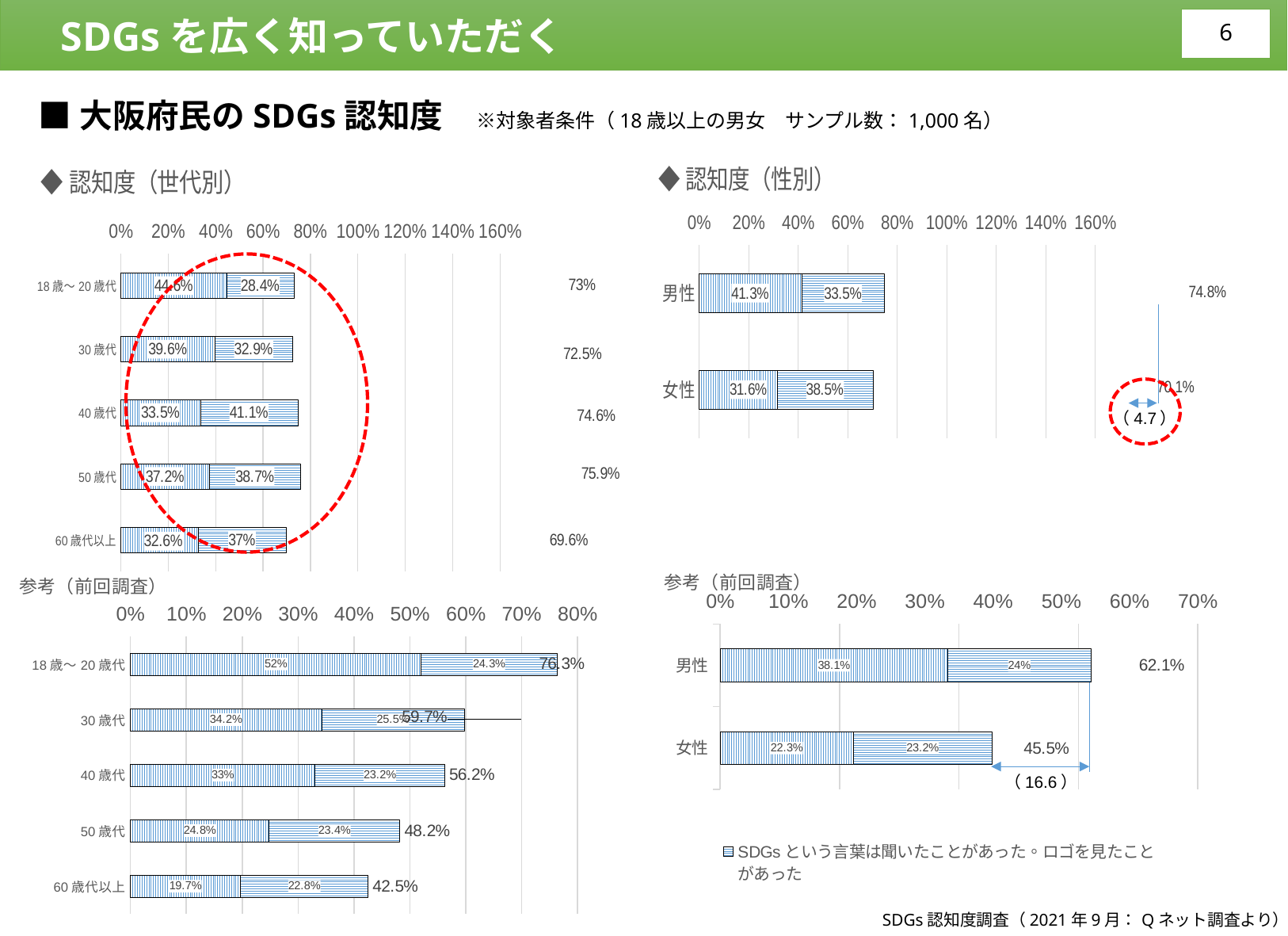
In the bottom-left chart 参考（前回調査） by age group, what is the total value shown for 18歳〜20歳代? 76.3% In the bottom-left chart 参考（前回調査） by age group, which age group has the highest total value? 18歳〜20歳代 In the top-right chart titled 認知度（性別）, what is the value of the second (right) segment for 女性? 38.5% In the bottom-right chart 参考（前回調査） by gender, what is the total value shown for 女性? 45.5% What kind of chart is the bottom-right chart 参考（前回調査） by gender? stacked bar chart In the bottom-left chart 参考（前回調査） by age group, do the total values rise or fall as the age groups get older? fall In the top-left chart titled 認知度（世代別）, what is the total value shown for 50歳代? 75.9% In the top-left chart titled 認知度（世代別）, how many age groups are plotted? 5 In the top-right chart titled 認知度（性別）, what is the difference between the totals for 男性 and 女性? 4.7 In the top-left chart titled 認知度（世代別）, what is the value of the first (left) segment for 18歳〜20歳代? 44.6% In the top-left chart titled 認知度（世代別）, which age group has the lowest total value? 60歳代以上 In the top-right chart titled 認知度（性別）, what is the total value shown for 男性? 74.8%